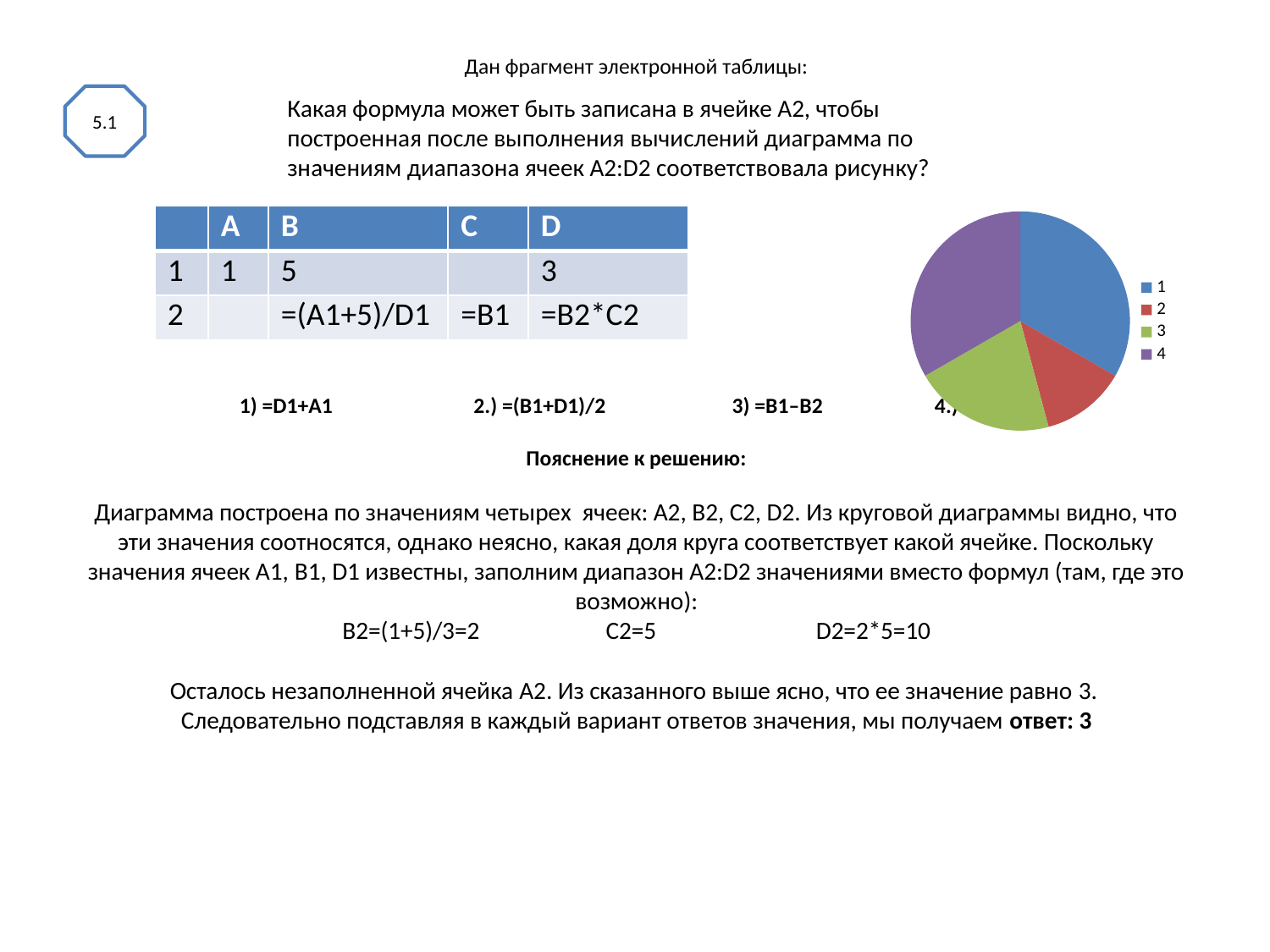
What entries does the legend of the pie chart list? 1, 2, 3, 4 Which slice of the pie chart is the smallest? 2 Which is larger in the pie chart, slice 2 or slice 4? 4 Which is larger in the pie chart, slice 2 or slice 3? 3 What kind of chart is shown on the slide? pie chart Which is larger in the pie chart, slice 2 or slice 1? 1 What colour is slice 2 in the pie chart? red How many slices does the pie chart have? 4